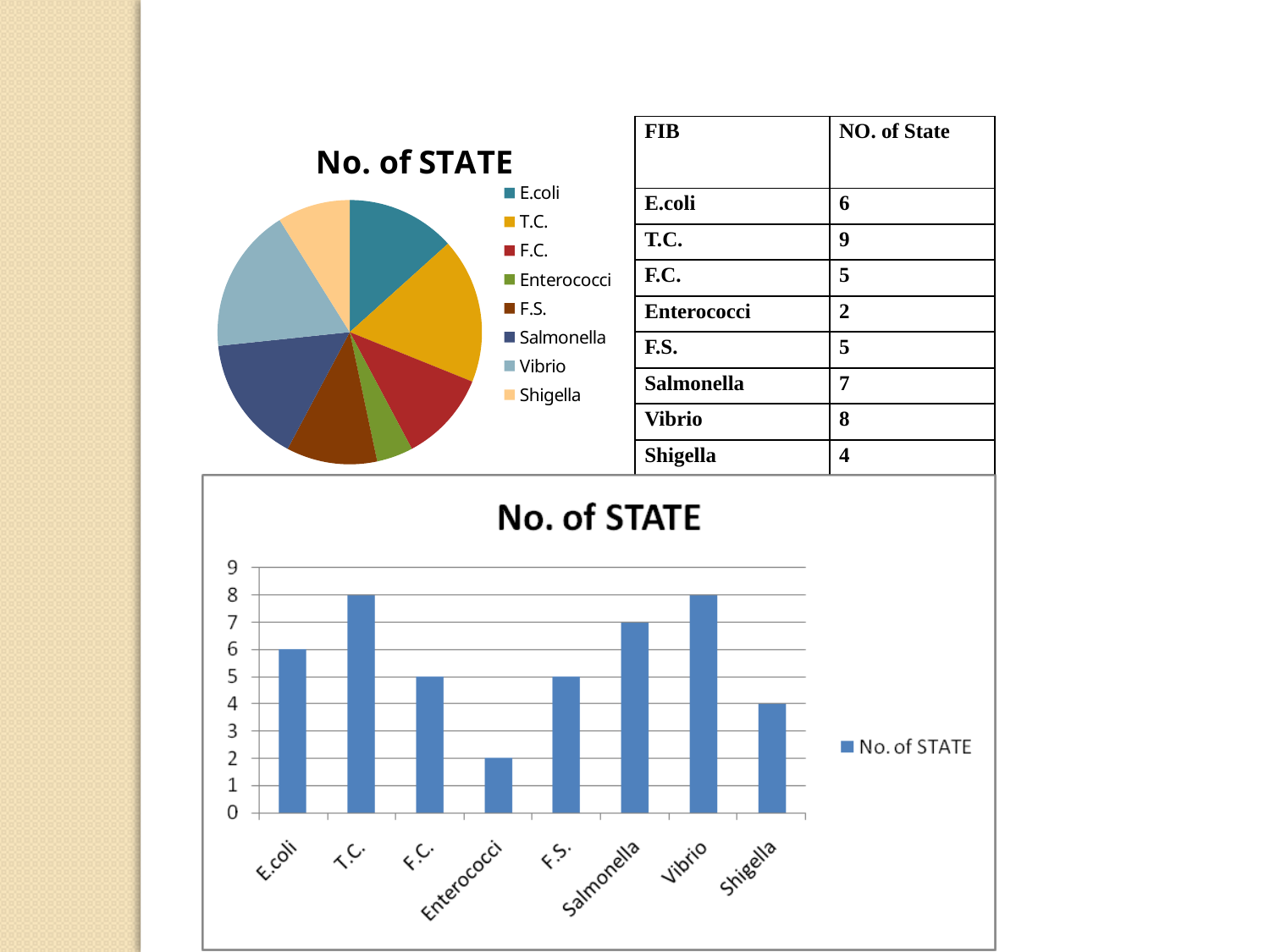
In the bar chart at the bottom of the slide, is the value for Shigella greater or less than 5? less In the bar chart at the bottom of the slide, which category has the lowest value? Enterococci In the bar chart at the bottom of the slide, what is the difference between the values for Vibrio and Shigella? 4 What kind of chart is the chart at the top left of the slide? pie chart What is the title of the pie chart at the top left of the slide? No. of STATE In the bar chart at the bottom of the slide, what is the value for Salmonella? 7 How many series does the legend of the bar chart at the bottom of the slide list? 1 How many slices does the pie chart at the top left of the slide have? 8 In the bar chart at the bottom of the slide, what is the value for E.coli? 6 In the bar chart at the bottom of the slide, which is larger, the value for Salmonella or the value for F.C.? Salmonella How many categories are shown on the x axis of the bar chart at the bottom of the slide? 8 In the bar chart at the bottom of the slide, what is the value for Enterococci? 2